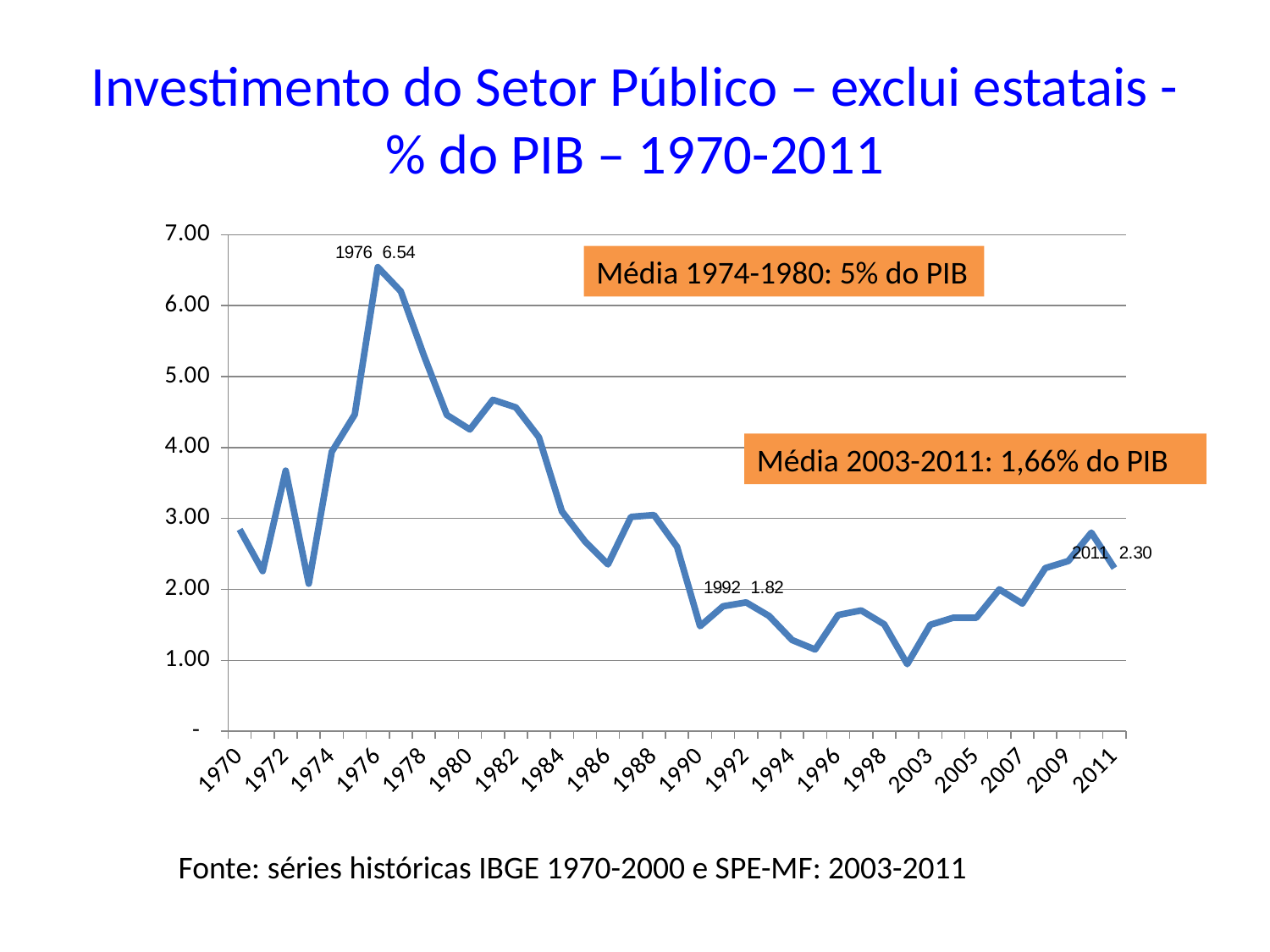
Is the value for 1986 greater or less than 3.00? less What is the value for 1992? 1.82 What is the value for 2011? 2.30 Which is larger, the value for 1992 or the value for 2011? 2011 Do the values rise or fall from 1976 to 1980? fall What is the difference between the values for 2011 and 1992? 0.48 According to the text box on the chart, what was the average for 1974-1980? 5% do PIB Which year has the highest value on the chart? 1976 Is the value for 1970 greater or less than 2.00? greater What kind of chart is shown on the slide? line chart What is the value for 1976? 6.54 What is the difference between the values for 1976 and 2011? 4.24